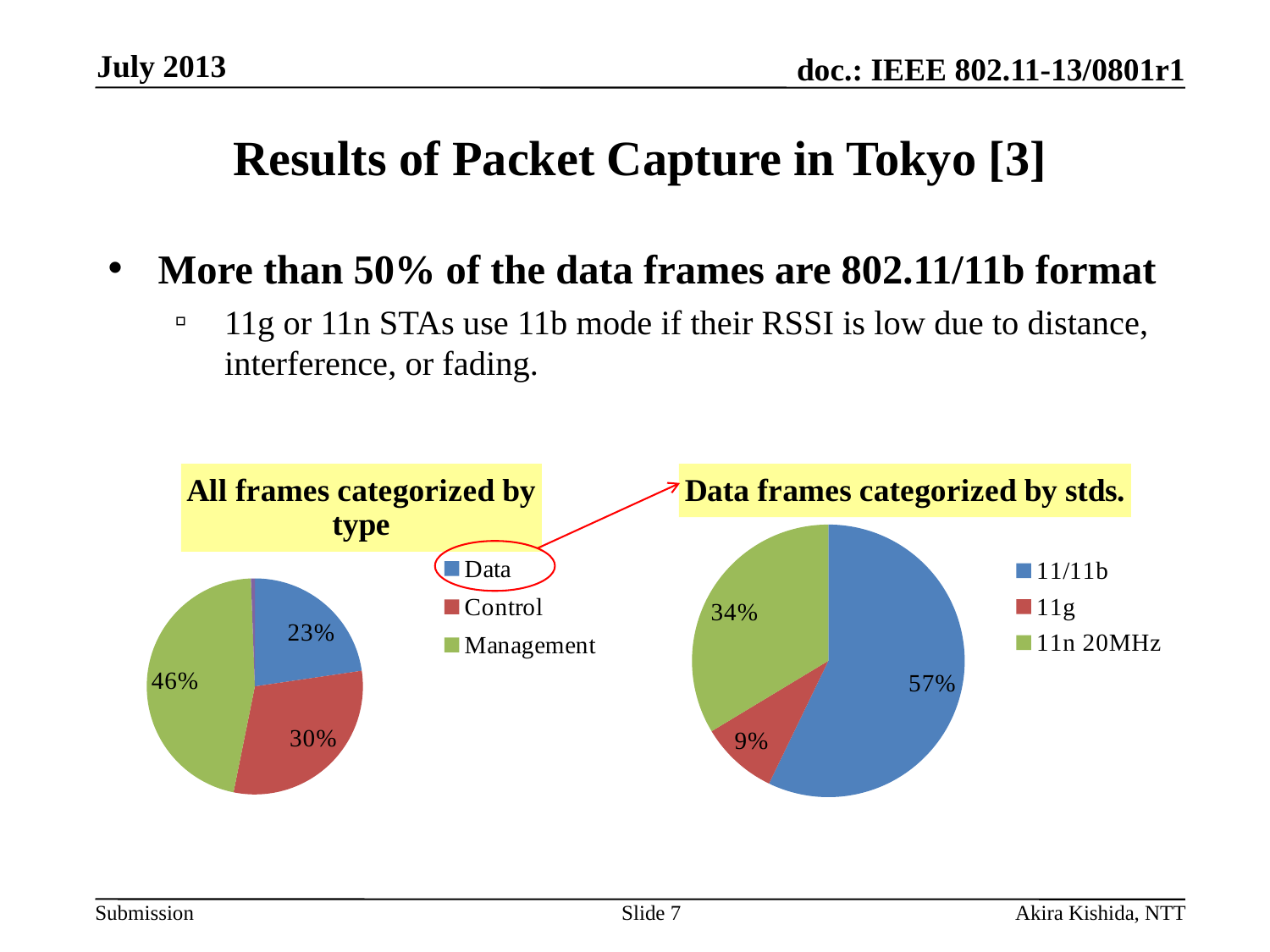
What kind of chart is 'Data frames categorized by stds.'? Pie chart In the 'Data frames categorized by stds.' chart, what is the difference between the 11/11b and 11g shares? 48% In the 'All frames categorized by type' chart, what share of frames is Management? 46% In the 'Data frames categorized by stds.' chart, what share of data frames is 11n 20MHz? 34% In the 'All frames categorized by type' chart, what share of frames is Data? 23% How many entries does the legend of the 'Data frames categorized by stds.' chart list? 3 In the 'All frames categorized by type' chart, which is larger, Control or Data? Control In the 'All frames categorized by type' chart, which labelled category has the largest share? Management In the 'All frames categorized by type' chart, what is the difference between the Management and Data shares? 23% In the 'Data frames categorized by stds.' chart, which standard has the smallest share? 11g